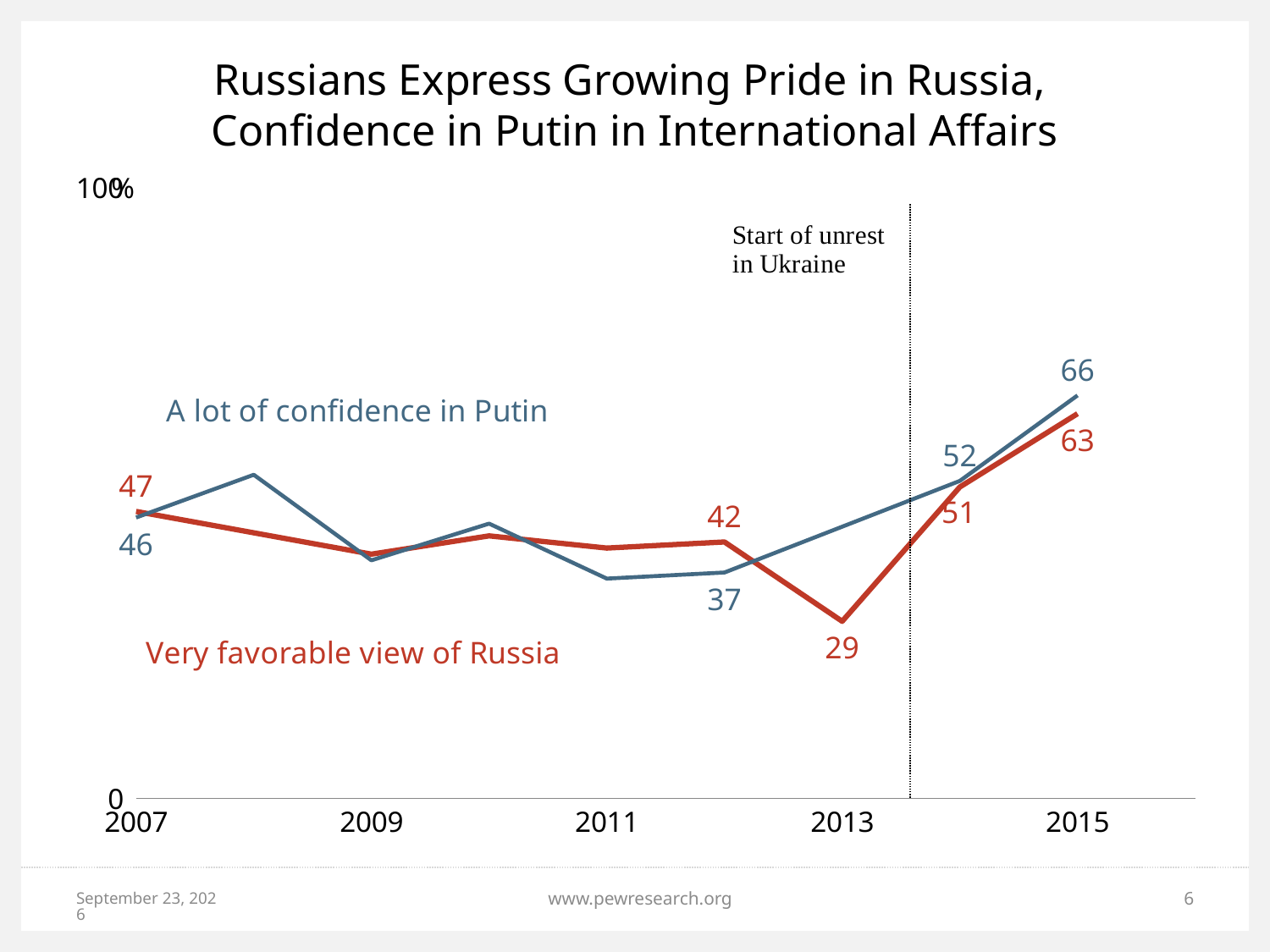
What was the value for 'Very favorable view of Russia' in 2015? 63 What event does the dotted vertical line on the chart mark? Start of unrest in Ukraine What percentage of Russians expressed a lot of confidence in Putin in 2015? 66 In 2012, which series had the higher value: 'A lot of confidence in Putin' or 'Very favorable view of Russia'? Very favorable view of Russia By how much did 'Very favorable view of Russia' increase from 2013 to 2015? 34 What was the value for 'Very favorable view of Russia' in 2007? 47 What was the value for 'A lot of confidence in Putin' in 2014? 52 What was the value for 'A lot of confidence in Putin' in 2012? 37 In which year did 'Very favorable view of Russia' reach its lowest labeled value? 2013 What kind of chart is shown on the slide? line chart What was the value for 'Very favorable view of Russia' in 2013? 29 In 2015, how many points higher is 'A lot of confidence in Putin' than 'Very favorable view of Russia'? 3